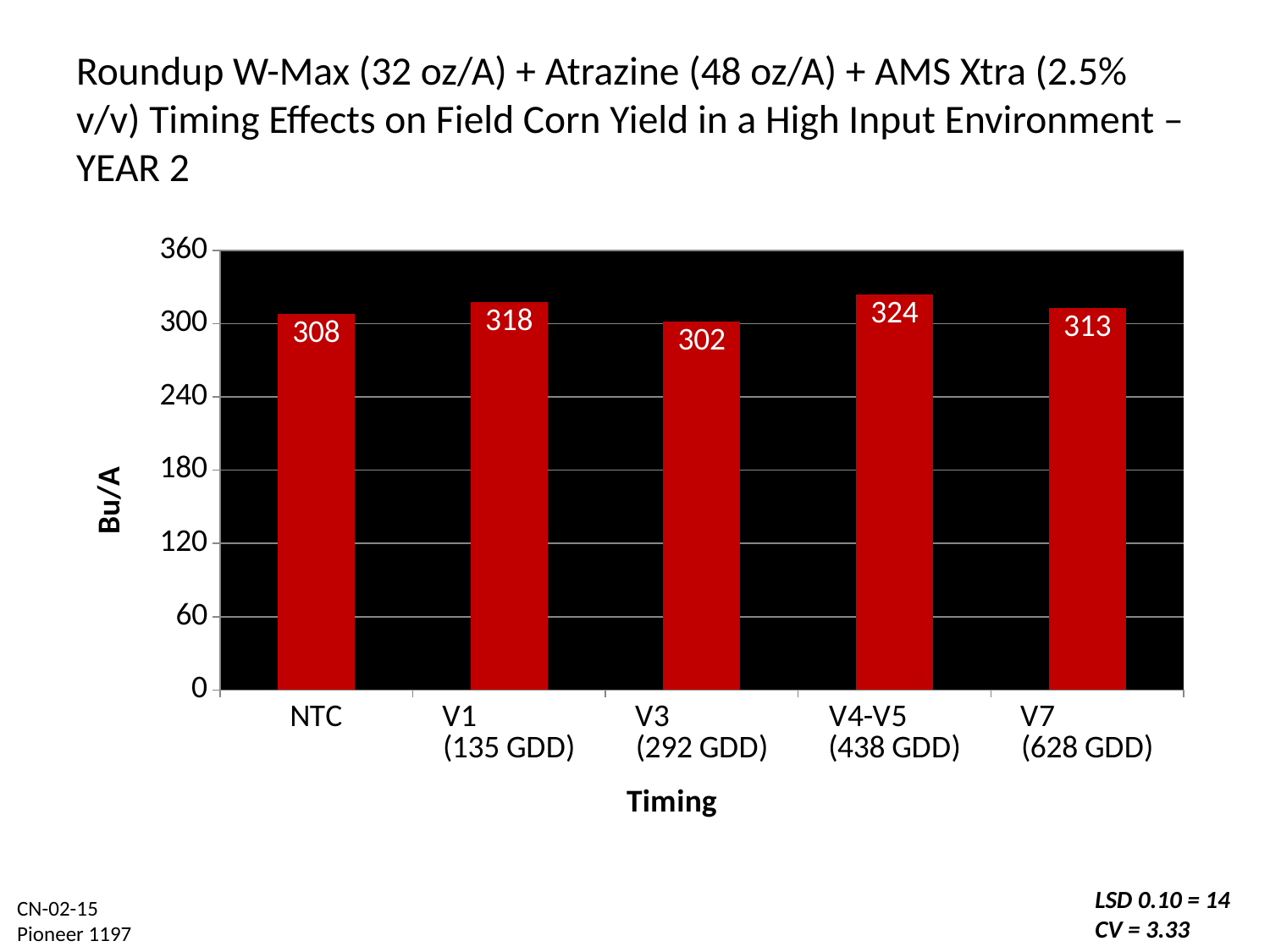
What is the yield (Bu/A) for the V7 (628 GDD) timing? 313 Which timing has the lowest yield? V3 (292 GDD) Which timing has the highest yield? V4-V5 (438 GDD) What is the yield (Bu/A) for the V1 (135 GDD) timing? 318 What is the yield (Bu/A) for the V3 (292 GDD) timing? 302 What is the label of the vertical axis? Bu/A Is the yield for the V3 (292 GDD) timing greater or less than 240? greater What is the difference in yield between the V4-V5 (438 GDD) timing and the V3 (292 GDD) timing? 22 Which has a higher yield, V1 (135 GDD) or V7 (628 GDD)? V1 (135 GDD) What is the yield (Bu/A) for the NTC timing? 308 How many timing categories are shown on the chart? 5 What kind of chart is shown on the slide? bar chart